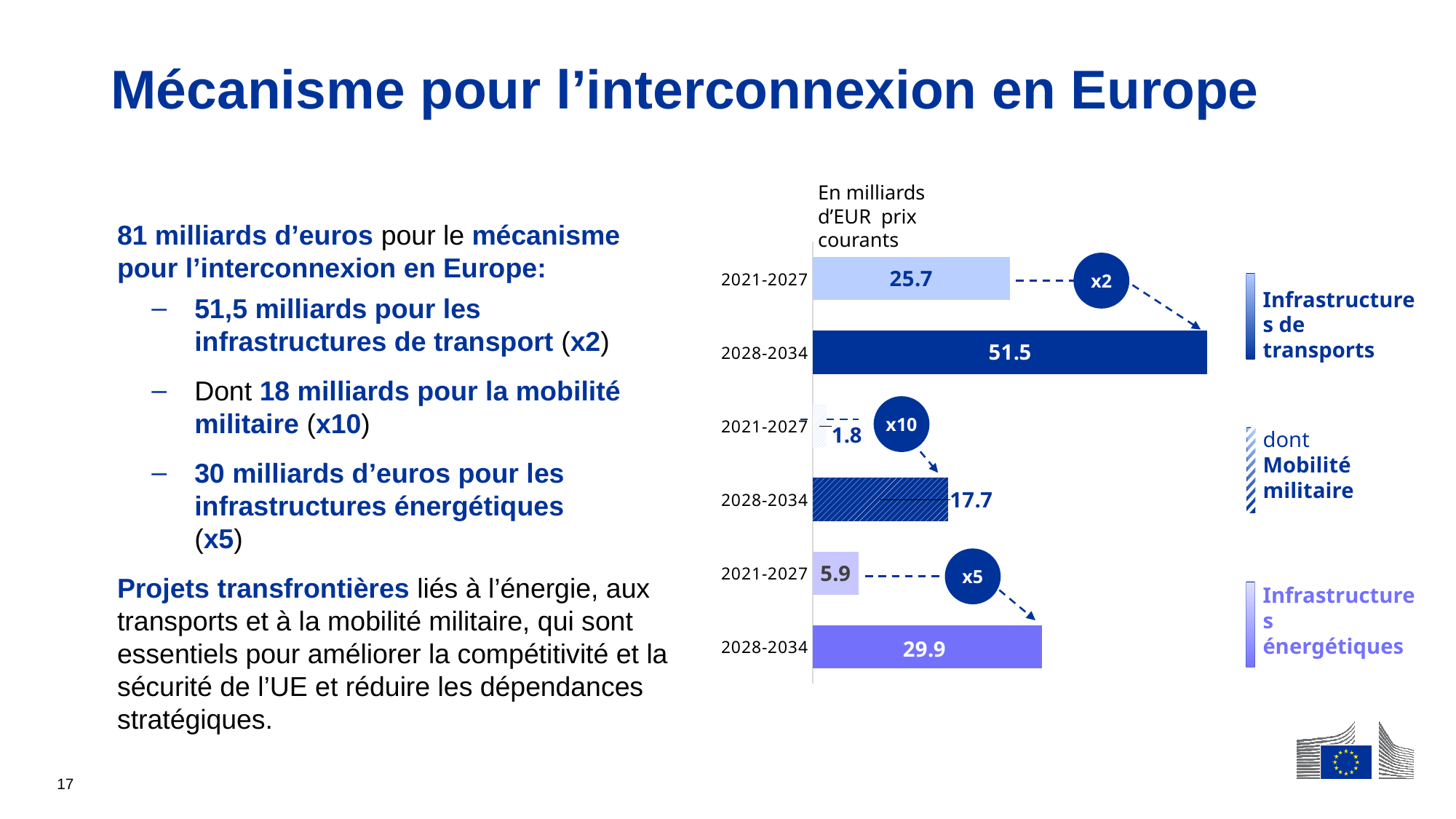
What multiplier is shown between the two Mobilité militaire bars? x10 What is the value for Mobilité militaire in 2021-2027? 1.8 Which is larger: Infrastructures de transports in 2021-2027 or Infrastructures énergétiques in 2028-2034? Infrastructures énergétiques in 2028-2034 Which bar has the lowest value in the chart? Mobilité militaire 2021-2027 What kind of chart is shown on the slide? Bar chart How many bars are plotted in the chart? 6 Which bar has the highest value in the chart? Infrastructures de transports 2028-2034 What is the value for Infrastructures de transports in 2028-2034? 51.5 What is the value for Infrastructures de transports in 2021-2027? 25.7 What is the difference between the Infrastructures énergétiques values for 2028-2034 and 2021-2027? 24.0 What is the value for Infrastructures énergétiques in 2028-2034? 29.9 What is the value for Mobilité militaire in 2028-2034? 17.7